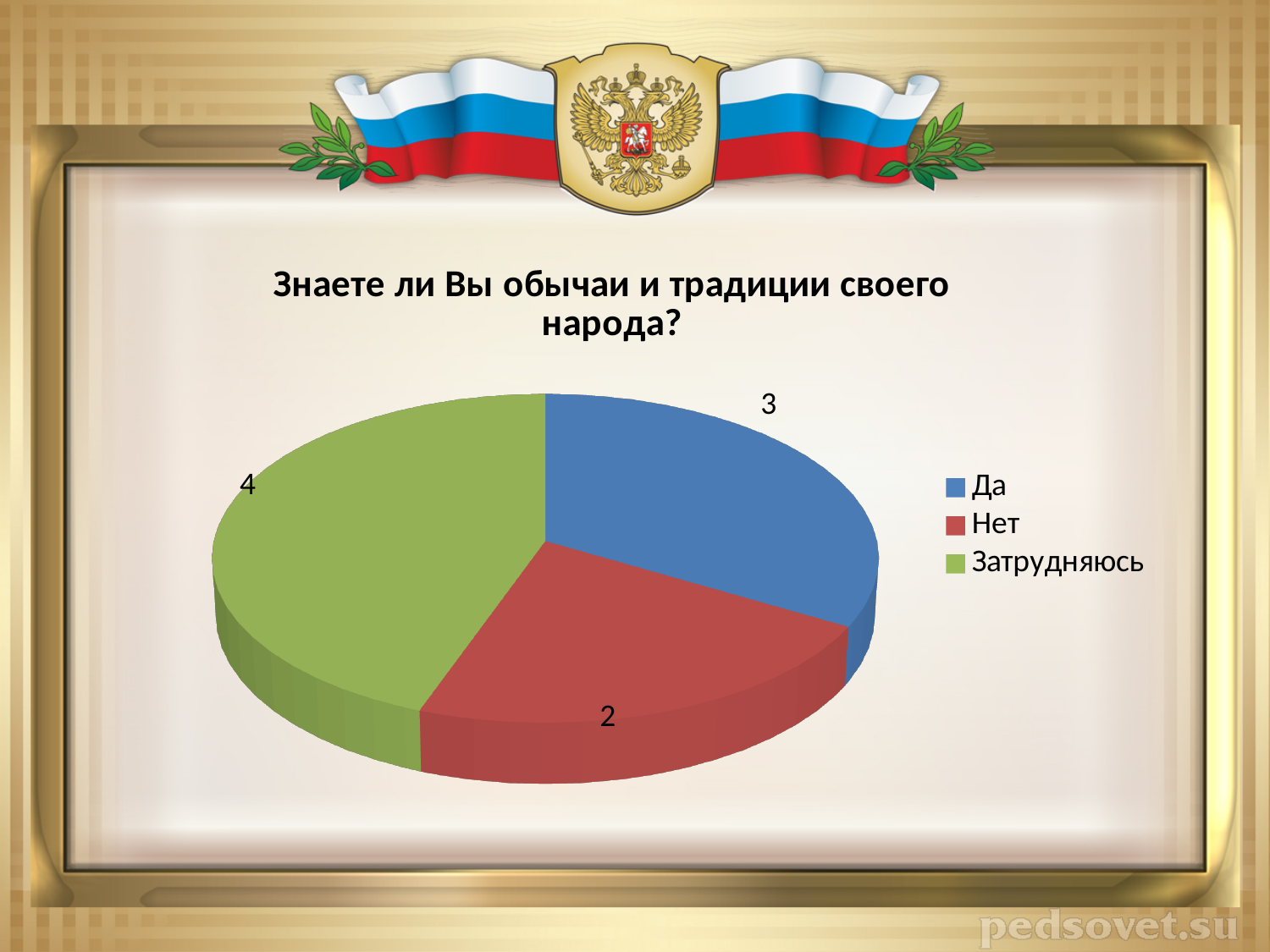
What is the value for Затрудняюсь? 4 What is the value for Нет? 2 What is the value for Да? 3 What type of chart is shown on the slide? pie chart Which category has the largest slice? Затрудняюсь Which colour represents Затрудняюсь in the legend? green Which category has the smallest slice? Нет How many categories does the pie chart have? 3 What is the difference between the values for Затрудняюсь and Нет? 2 What is the title of the chart? Знаете ли Вы обычаи и традиции своего народа? What is the total of all slices in the pie chart? 9 Which is larger, the value for Да or the value for Нет? Да